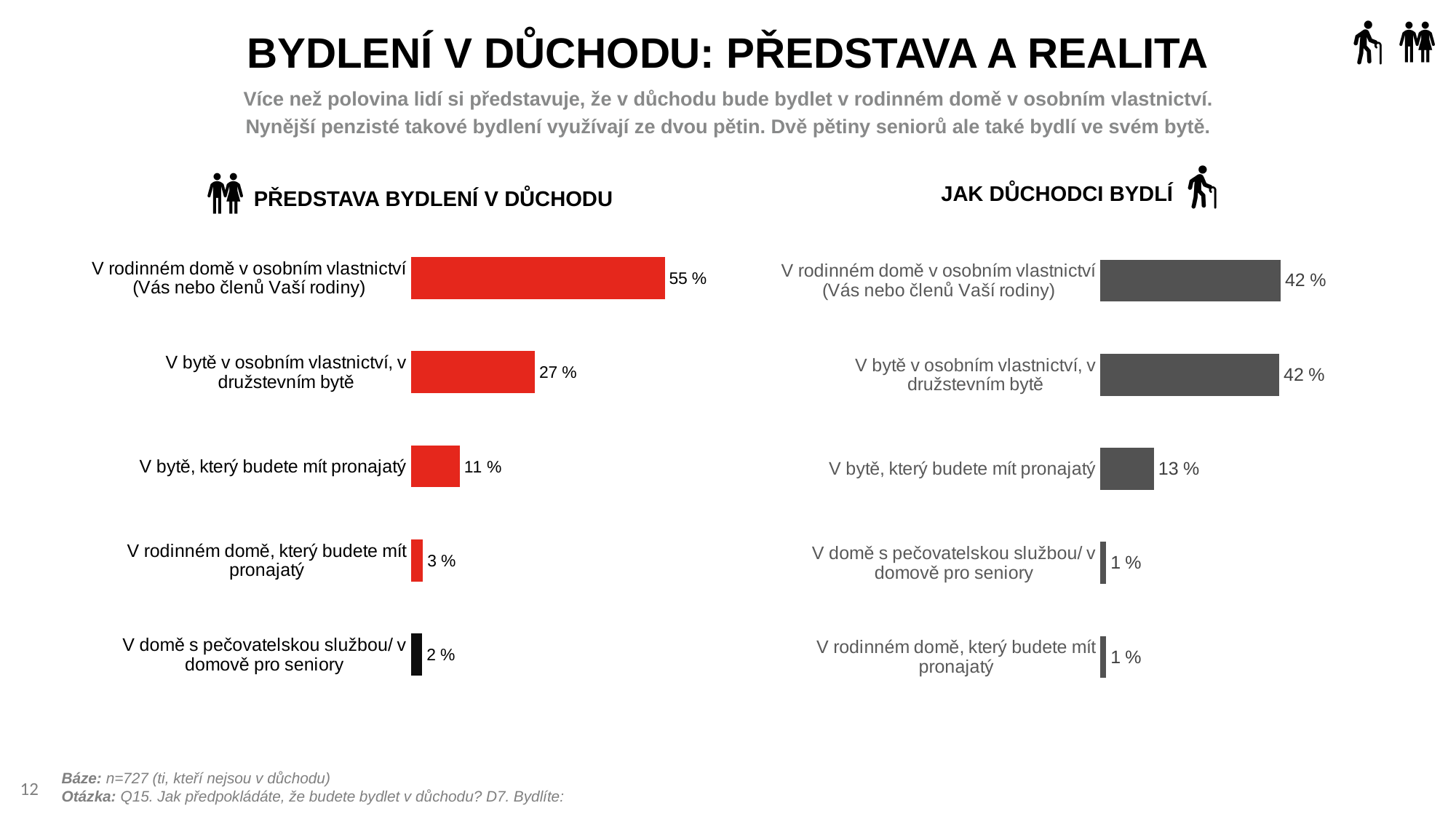
In the 'PŘEDSTAVA BYDLENÍ V DŮCHODU' chart, what is the value for 'V rodinném domě v osobním vlastnictví (Vás nebo členů Vaší rodiny)'? 55 % What colour are the bars in the 'PŘEDSTAVA BYDLENÍ V DŮCHODU' chart for the top three categories? Red Which is larger: the value for 'V bytě, který budete mít pronajatý' in the 'PŘEDSTAVA BYDLENÍ V DŮCHODU' chart or in the 'JAK DŮCHODCI BYDLÍ' chart? JAK DŮCHODCI BYDLÍ In the 'JAK DŮCHODCI BYDLÍ' chart, what is the value for 'V bytě, který budete mít pronajatý'? 13 % In the 'PŘEDSTAVA BYDLENÍ V DŮCHODU' chart, what is the difference between 'V rodinném domě v osobním vlastnictví' and 'V bytě v osobním vlastnictví, v družstevním bytě'? 28 % In the 'PŘEDSTAVA BYDLENÍ V DŮCHODU' chart, which category has the lowest value? V domě s pečovatelskou službou/ v domově pro seniory In the 'JAK DŮCHODCI BYDLÍ' chart, what is the difference between 'V bytě v osobním vlastnictví, v družstevním bytě' and 'V bytě, který budete mít pronajatý'? 29 % In the 'JAK DŮCHODCI BYDLÍ' chart, what is the value for 'V domě s pečovatelskou službou/ v domově pro seniory'? 1 % How many categories does the 'JAK DŮCHODCI BYDLÍ' chart show? 5 In the 'PŘEDSTAVA BYDLENÍ V DŮCHODU' chart, which category has the highest value? V rodinném domě v osobním vlastnictví (Vás nebo členů Vaší rodiny) In the 'PŘEDSTAVA BYDLENÍ V DŮCHODU' chart, what is the value for 'V rodinném domě, který budete mít pronajatý'? 3 % What type of chart is the 'PŘEDSTAVA BYDLENÍ V DŮCHODU' chart? Bar chart